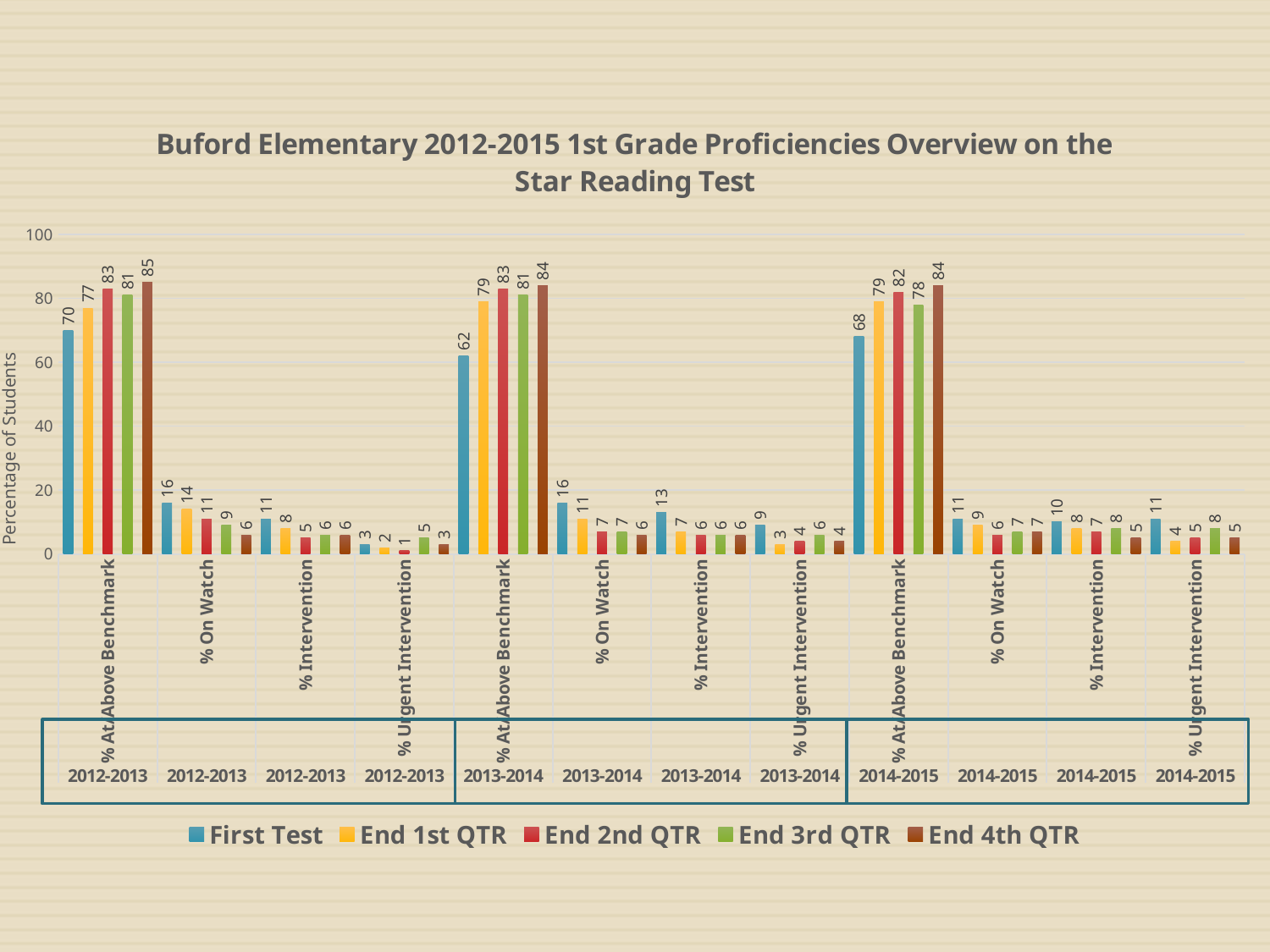
Which is larger for % On Watch in 2012-2013: the First Test value or the End 4th QTR value? First Test What is the End 3rd QTR value for % At/Above Benchmark in 2014-2015? 78 What is the First Test value for % At/Above Benchmark in 2012-2013? 70 How do the % At/Above Benchmark values change from First Test to End 2nd QTR in 2014-2015? They rise What kind of chart is shown on the slide? Bar chart How many series does the legend list? 5 What is the End 2nd QTR value for % Urgent Intervention in 2012-2013? 1 Which series has the highest value for % At/Above Benchmark in 2012-2013? End 4th QTR What is the label of the y axis? Percentage of Students What is the difference between the End 4th QTR and First Test values for % At/Above Benchmark in 2013-2014? 22 What is the End 4th QTR value for % At/Above Benchmark in 2013-2014? 84 Which series has the lowest value for % At/Above Benchmark in 2013-2014? First Test